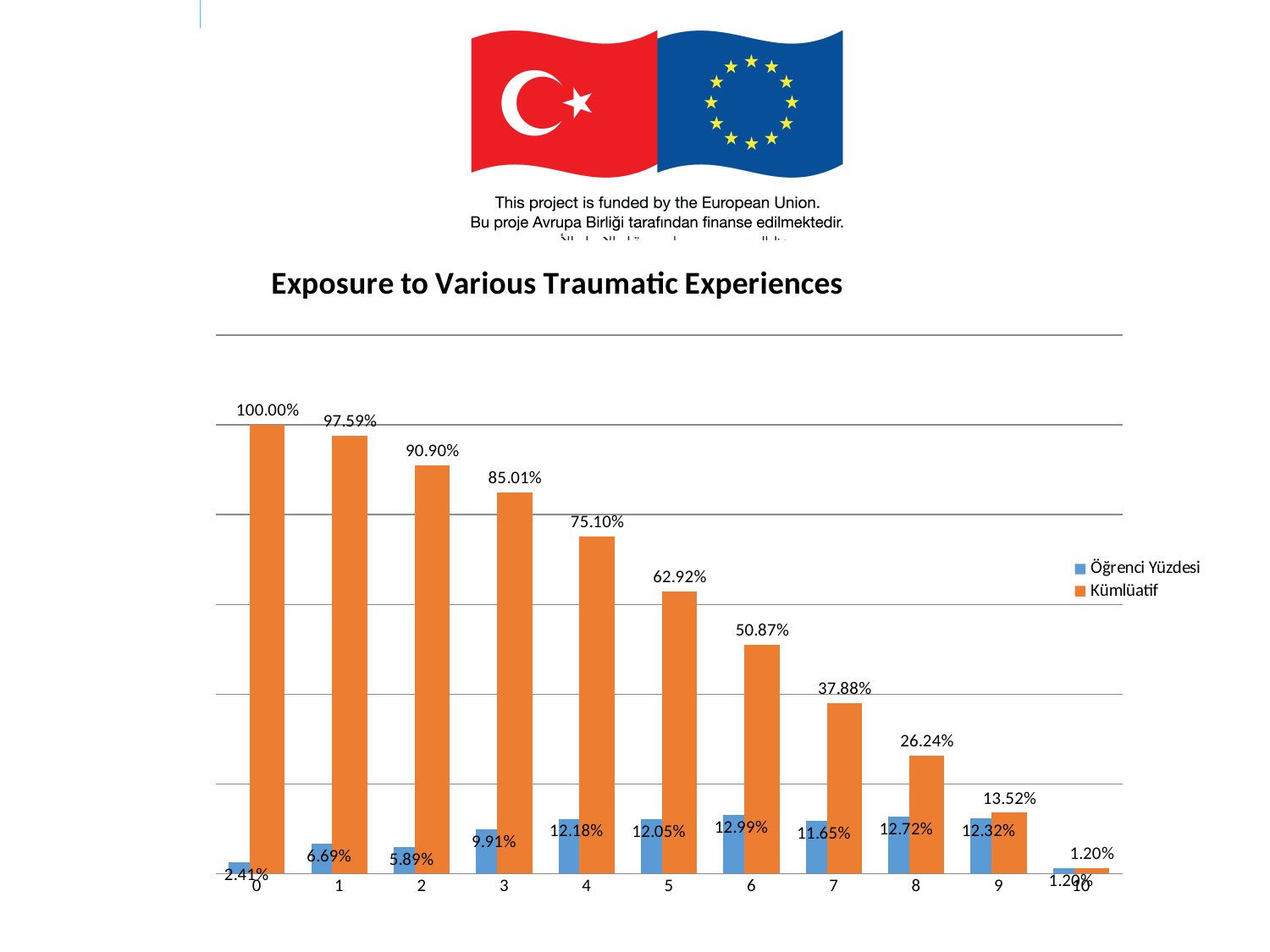
What is the title of the chart? Exposure to Various Traumatic Experiences What is the difference between the Kümlüatif values for categories 0 and 1? 2.41% What is the Öğrenci Yüzdesi value for category 3? 9.91% What is the Kümlüatif value for category 4? 75.10% How many categories are shown on the x axis? 11 What kind of chart is shown on the slide? Bar chart What is the Kümlüatif value for category 7? 37.88% Which category has the lowest Kümlüatif value? 10 How many series does the legend list? 2 Do the Kümlüatif values rise or fall as the category number increases from 0 to 10? Fall Which is larger, the Öğrenci Yüzdesi value for category 1 or for category 2? Category 1 Which category has the highest Öğrenci Yüzdesi value? 6